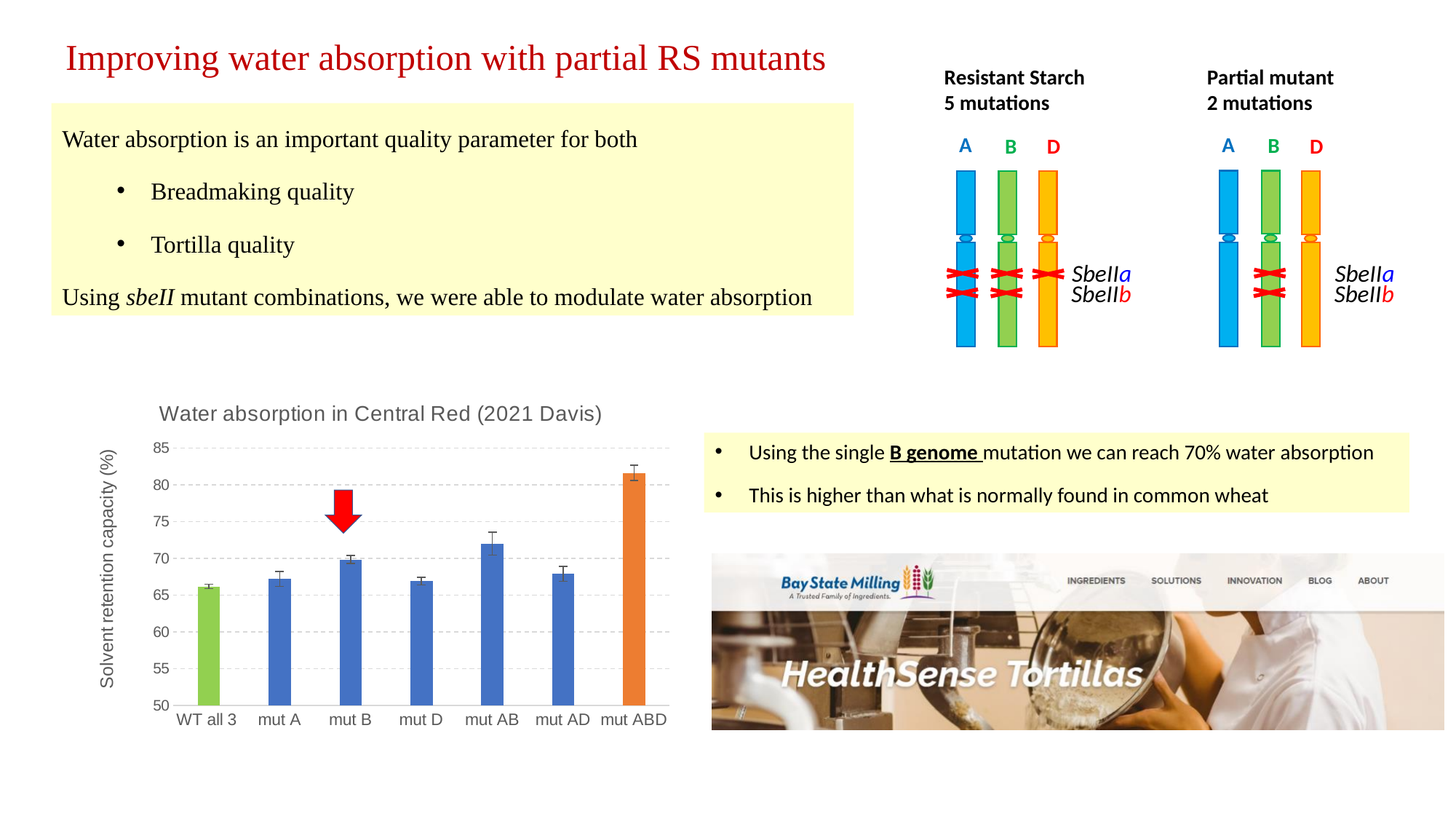
Is the value for mut ABD greater or less than 80? greater Which category's bar is marked with a red arrow in the chart? mut B How many categories are plotted on the x axis of the chart? 7 Which is larger, the value for mut AB or the value for mut A? mut AB What is the title of the chart? Water absorption in Central Red (2021 Davis) Is the value for mut AB greater or less than 70? greater Which is larger, the value for mut ABD or the value for mut AB? mut ABD What type of chart is shown on the slide? bar chart What is the label of the y axis of the chart? Solvent retention capacity (%) Which category has the highest solvent retention capacity in the chart? mut ABD Is the value for mut AD greater or less than 70? less